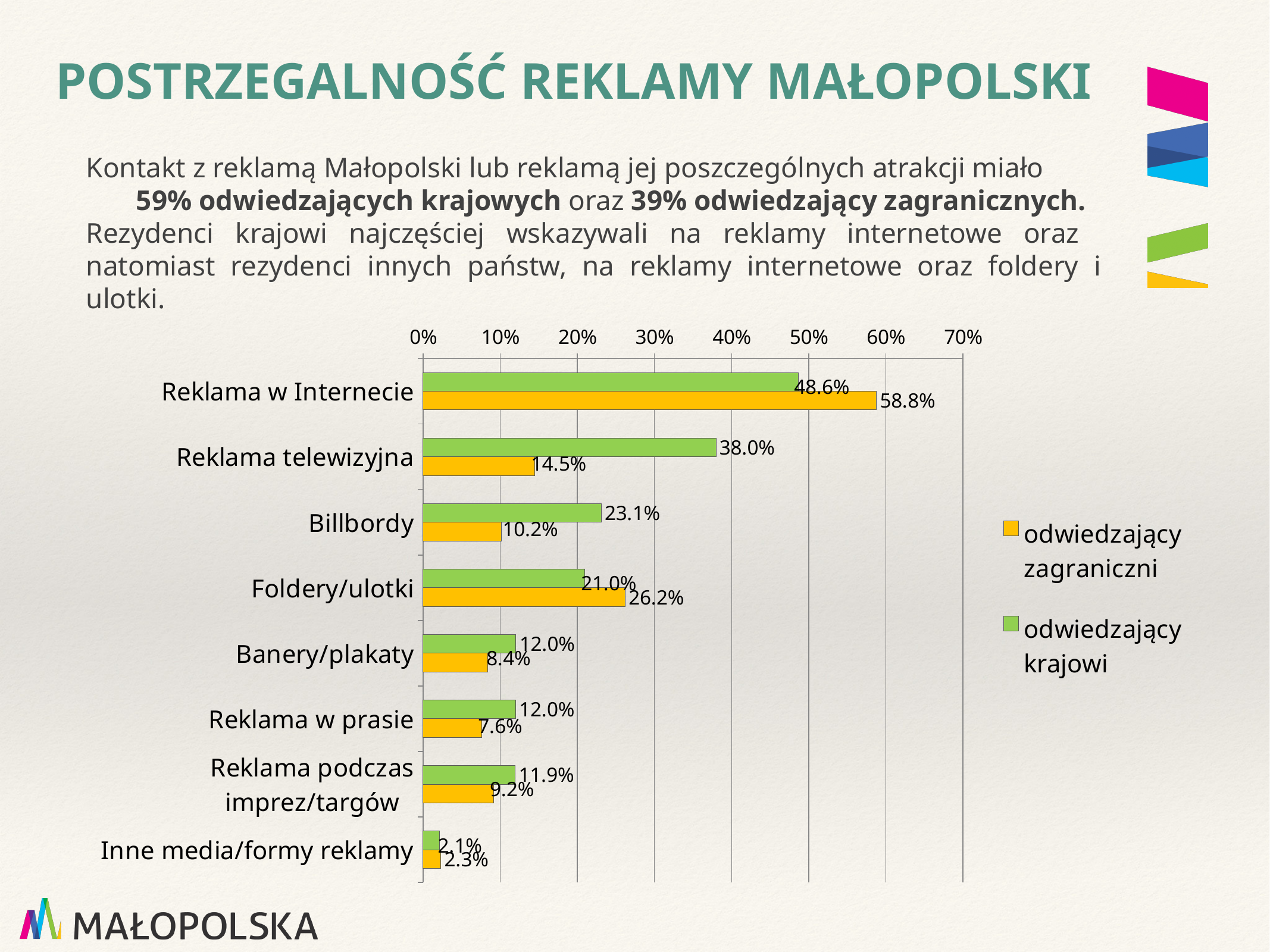
How many categories of advertising are shown on the chart? 8 Is the 'odwiedzający krajowi' value for 'Reklama w Internecie' greater or less than 40%? greater What is the difference between the 'odwiedzający krajowi' and 'odwiedzający zagraniczni' values for 'Reklama telewizyjna'? 23.5% Which category has the lowest value for 'odwiedzający zagraniczni'? Inne media/formy reklamy How many series does the chart legend list? 2 What is the value for 'odwiedzający krajowi' for 'Reklama telewizyjna'? 38.0% Which colour represents 'odwiedzający zagraniczni' in the chart? yellow What is the value for 'odwiedzający zagraniczni' for 'Foldery/ulotki'? 26.2% What kind of chart is shown on the slide? bar chart For 'Billbordy', which series has the larger value: 'odwiedzający krajowi' or 'odwiedzający zagraniczni'? odwiedzający krajowi Which category has the highest value for 'odwiedzający krajowi'? Reklama w Internecie What is the value for 'odwiedzający zagraniczni' for 'Reklama w Internecie'? 58.8%